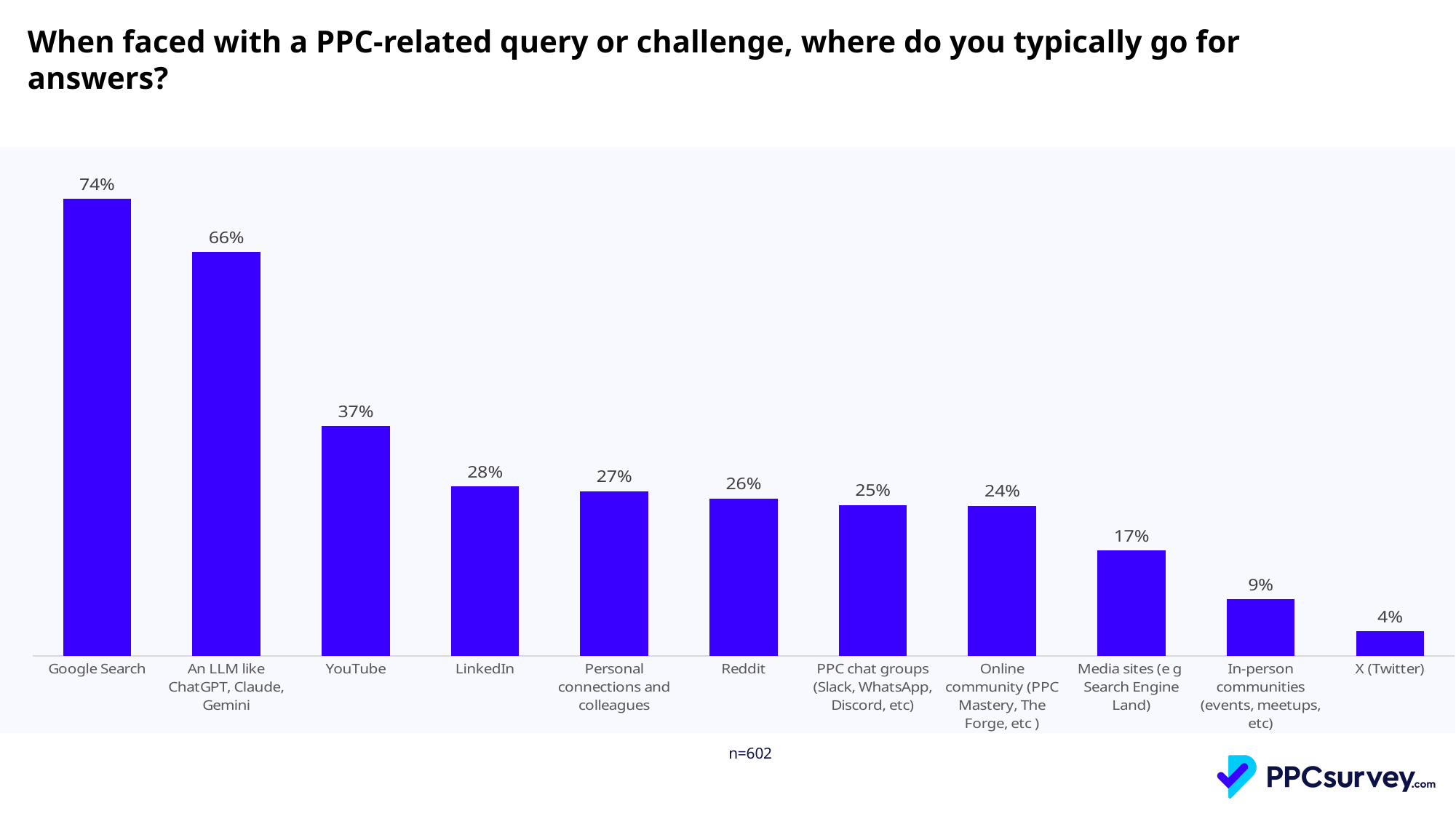
What percentage is shown for Reddit? 26% What is the sample size (n) noted below the chart? n=602 Which source has the highest percentage? Google Search Which has a higher value, YouTube or LinkedIn? YouTube How many sources (categories) are shown in the chart? 11 What is the value for Media sites (e g Search Engine Land)? 17% What is the difference in percentage points between LinkedIn and In-person communities (events, meetups, etc)? 19 Which source has the lowest percentage? X (Twitter) What is the difference in percentage points between Google Search and An LLM like ChatGPT, Claude, Gemini? 8 What is the value shown for YouTube? 37% What percentage of respondents go to Google Search for answers to PPC-related queries? 74% What kind of chart is shown on the slide? Bar chart